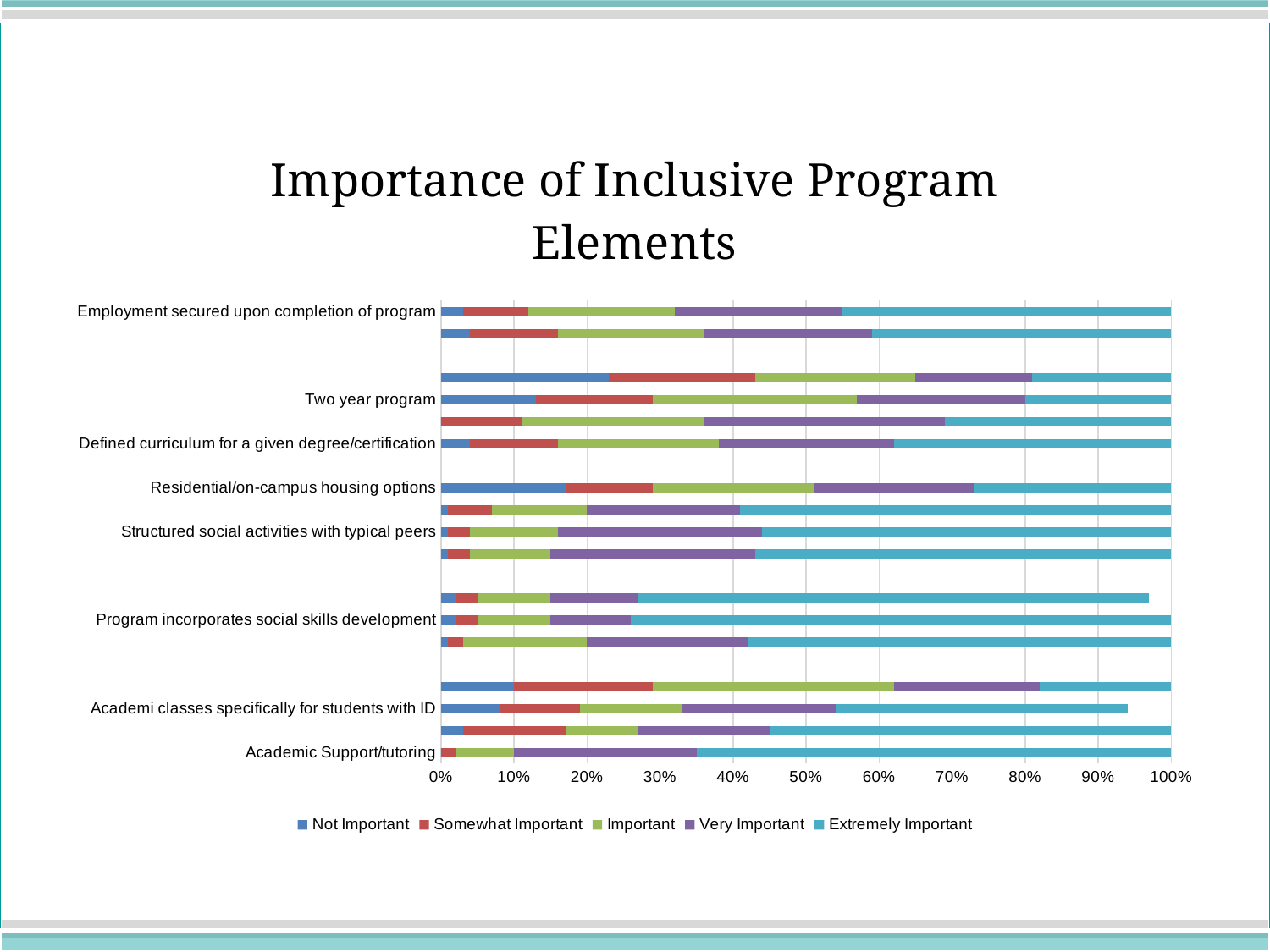
Which has the larger Extremely Important share: Academic Support/tutoring or Two year program? Academic Support/tutoring What is the title of the chart? Importance of Inclusive Program Elements Which has the larger Somewhat Important share: Two year program or Academic Support/tutoring? Two year program Is the Extremely Important share for Academic Support/tutoring greater or less than 50%? greater Which has the larger Not Important share: Residential/on-campus housing options or Academic Support/tutoring? Residential/on-campus housing options Which legend entry is shown in red? Somewhat Important How many series does the legend list? 5 What kind of chart is shown on the slide? Stacked bar chart Is the Extremely Important share for Two year program greater or less than 30%? less Is the Not Important share for Residential/on-campus housing options greater or less than 10%? greater